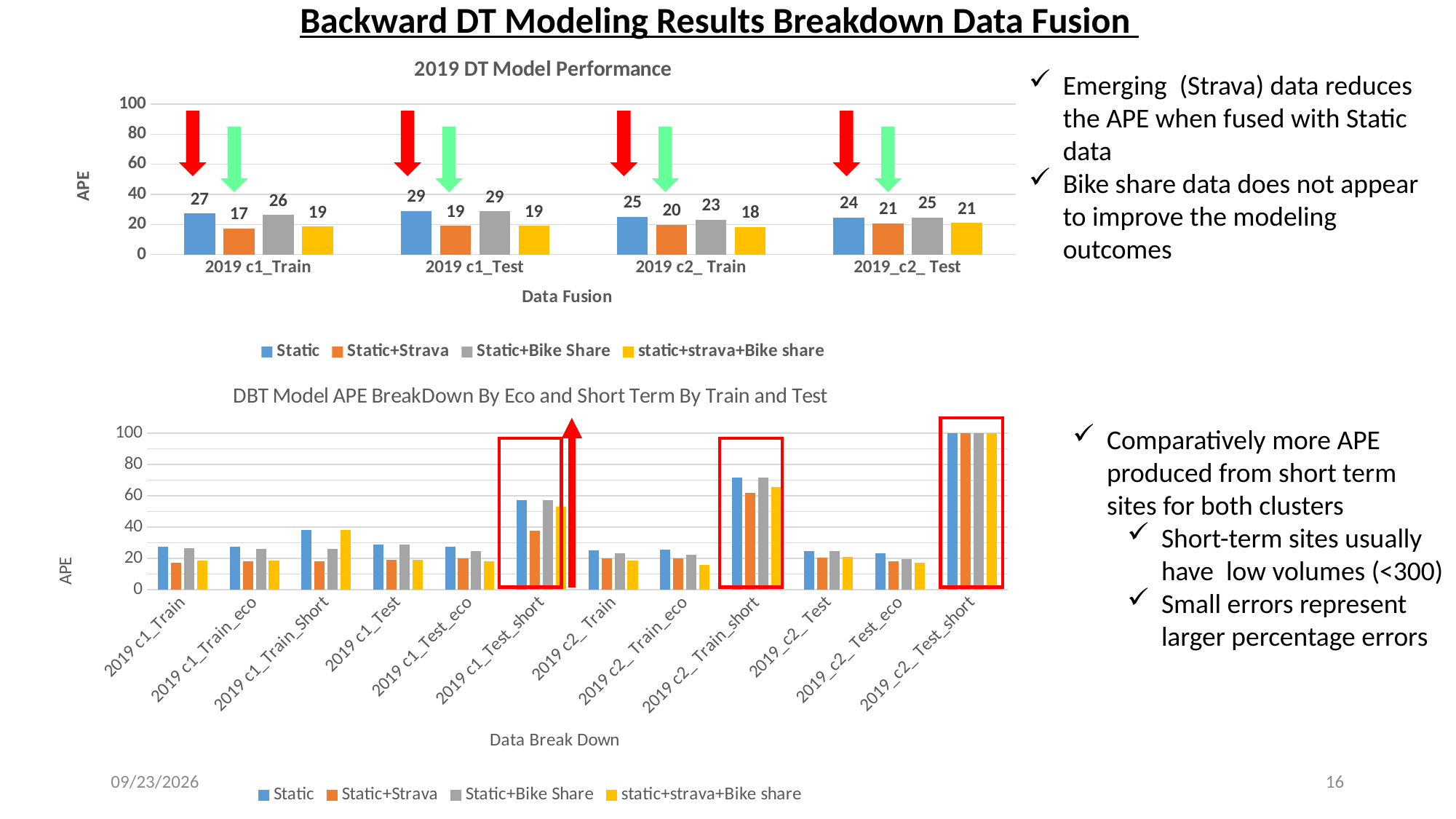
In the 2019 DT Model Performance chart, which series has the lowest APE in 2019 c1_Train? Static+Strava In the 2019 DT Model Performance chart, what is the APE for Static in 2019 c1_Test? 29 In the DBT Model APE BreakDown chart, is the Static value for 2019_c2_ Test_short greater or less than 80? greater In the 2019 DT Model Performance chart, which is larger in 2019 c2_ Train: the Static value or the Static+Bike Share value? Static How many categories are shown on the x axis of the DBT Model APE BreakDown chart? 12 In the 2019 DT Model Performance chart, what is the APE for static+strava+Bike share in 2019 c2_ Train? 18 In the 2019 DT Model Performance chart, which series has the highest APE in 2019_c2_ Test? Static+Bike Share In the 2019 DT Model Performance chart, what is the difference between the Static and Static+Strava APE values in 2019 c1_Test? 10 In the DBT Model APE BreakDown chart, is the Static value for 2019 c1_Train_eco greater or less than 40? less In the 2019 DT Model Performance chart, what is the APE for Static+Strava in 2019 c1_Train? 17 How many series does the legend of the 2019 DT Model Performance chart list? 4 What type of chart is the DBT Model APE BreakDown By Eco and Short Term By Train and Test chart? Bar chart